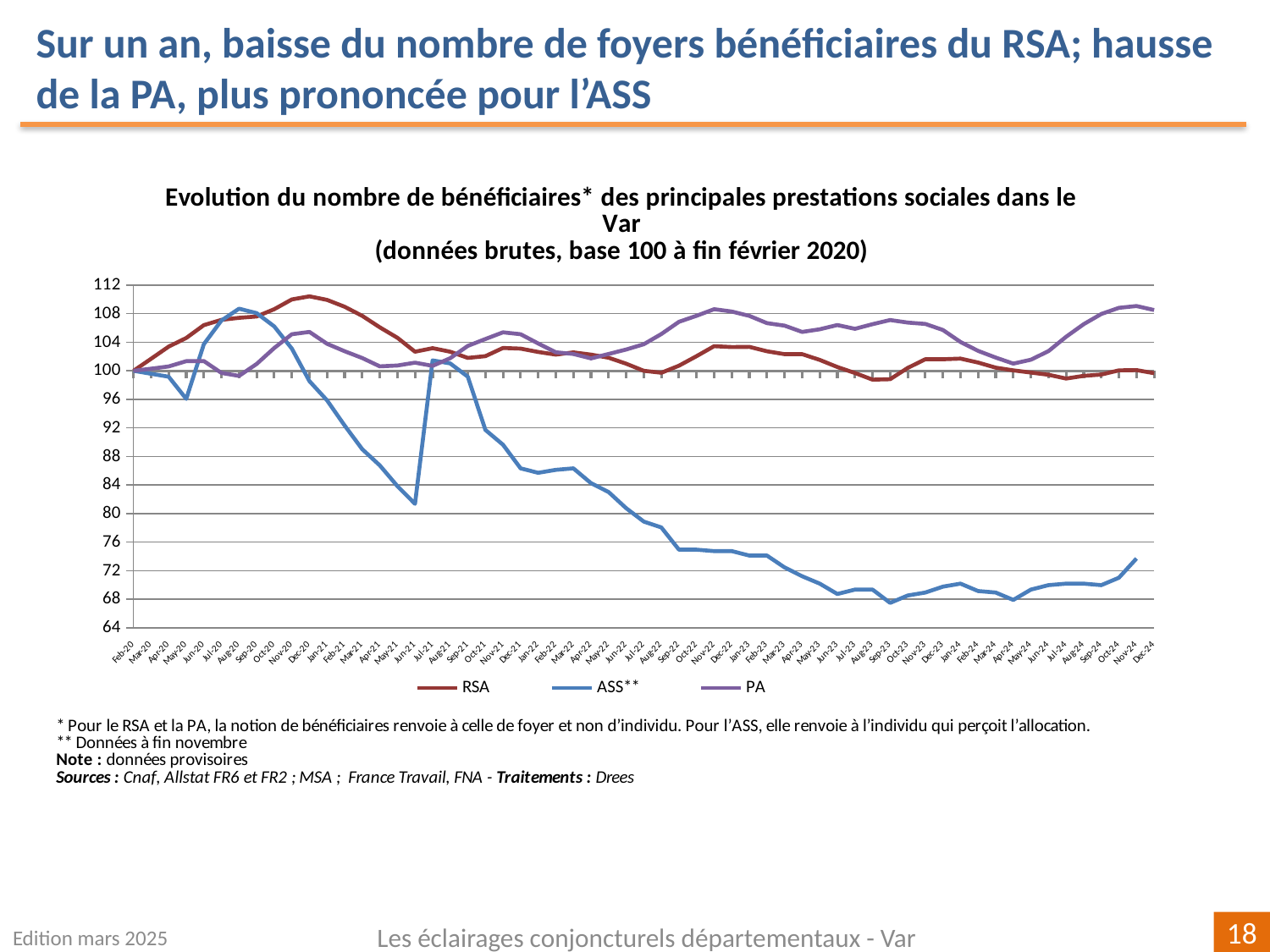
What are the three series named in the legend? RSA, ASS**, PA What is the base month and value used for the index in this chart, according to the chart title? base 100 à fin février 2020 Is the value of the ASS** series at Jun-23 greater or less than 72? less What kind of chart is shown on the slide? line chart What is the value of all three series at Feb-20, the base month? 100 How many series does the legend list? 3 Is the value of the RSA series at Dec-20 greater or less than 108? greater Is the value of the PA series at Nov-24 greater or less than 108? greater Which series has the lowest value at Dec-24? RSA Overall, does the ASS** series rise or fall between Feb-20 and Dec-24? fall